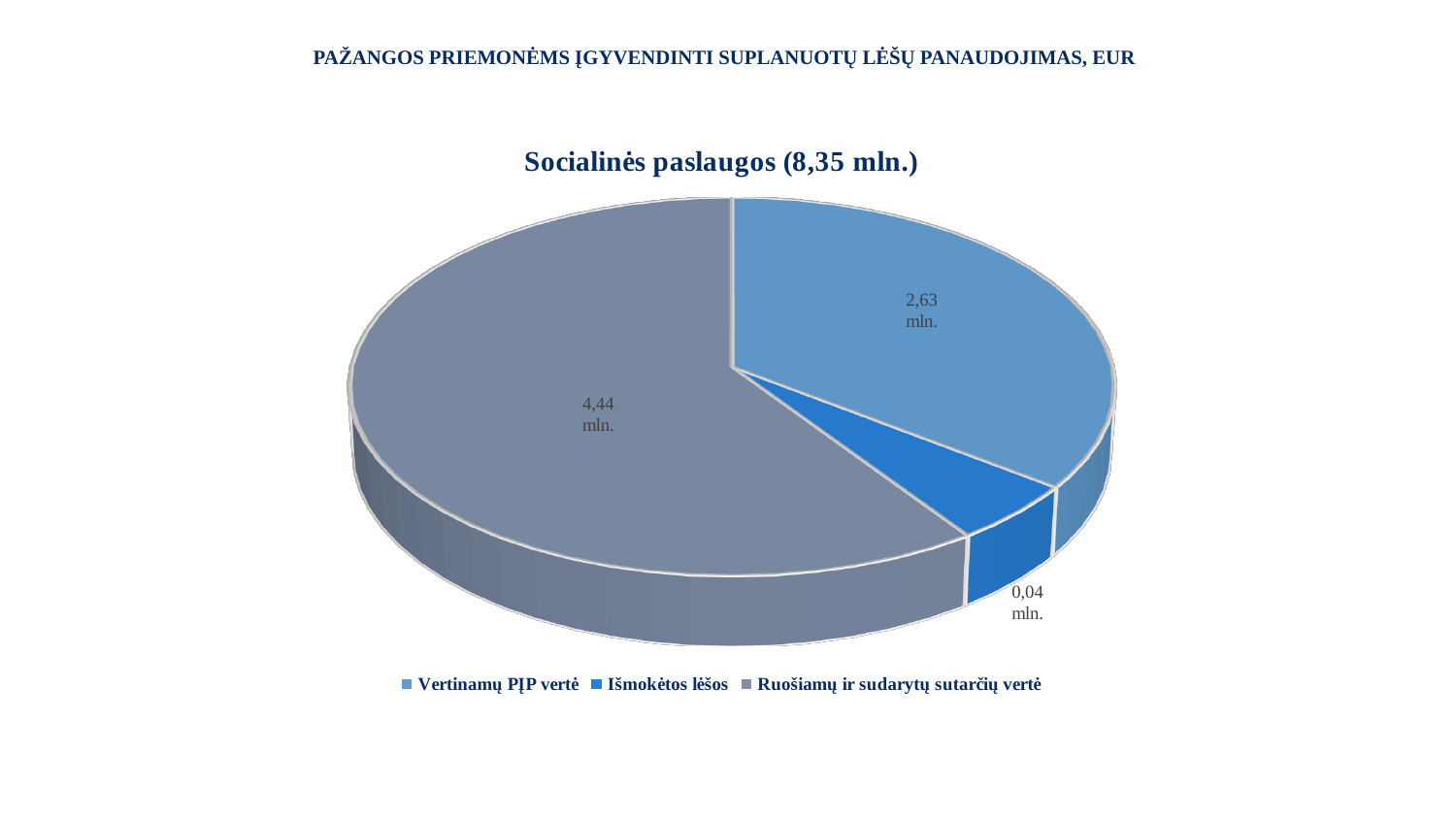
Which is larger, Vertinamų PĮP vertė or Išmokėtos lėšos? Vertinamų PĮP vertė What is the value for Ruošiamų ir sudarytų sutarčių vertė? 4,44 mln. How many slices does the pie chart have? 3 What is the title of the chart? Socialinės paslaugos (8,35 mln.) What is the value for Vertinamų PĮP vertė? 2,63 mln. What kind of chart is shown on the slide? Pie chart What is the difference between Ruošiamų ir sudarytų sutarčių vertė and Vertinamų PĮP vertė? 1,81 mln. What is the difference between Vertinamų PĮP vertė and Išmokėtos lėšos? 2,59 mln. How many entries does the legend list? 3 Which category has the smallest slice of the pie? Išmokėtos lėšos What is the value for Išmokėtos lėšos? 0,04 mln. Which category has the largest slice of the pie? Ruošiamų ir sudarytų sutarčių vertė